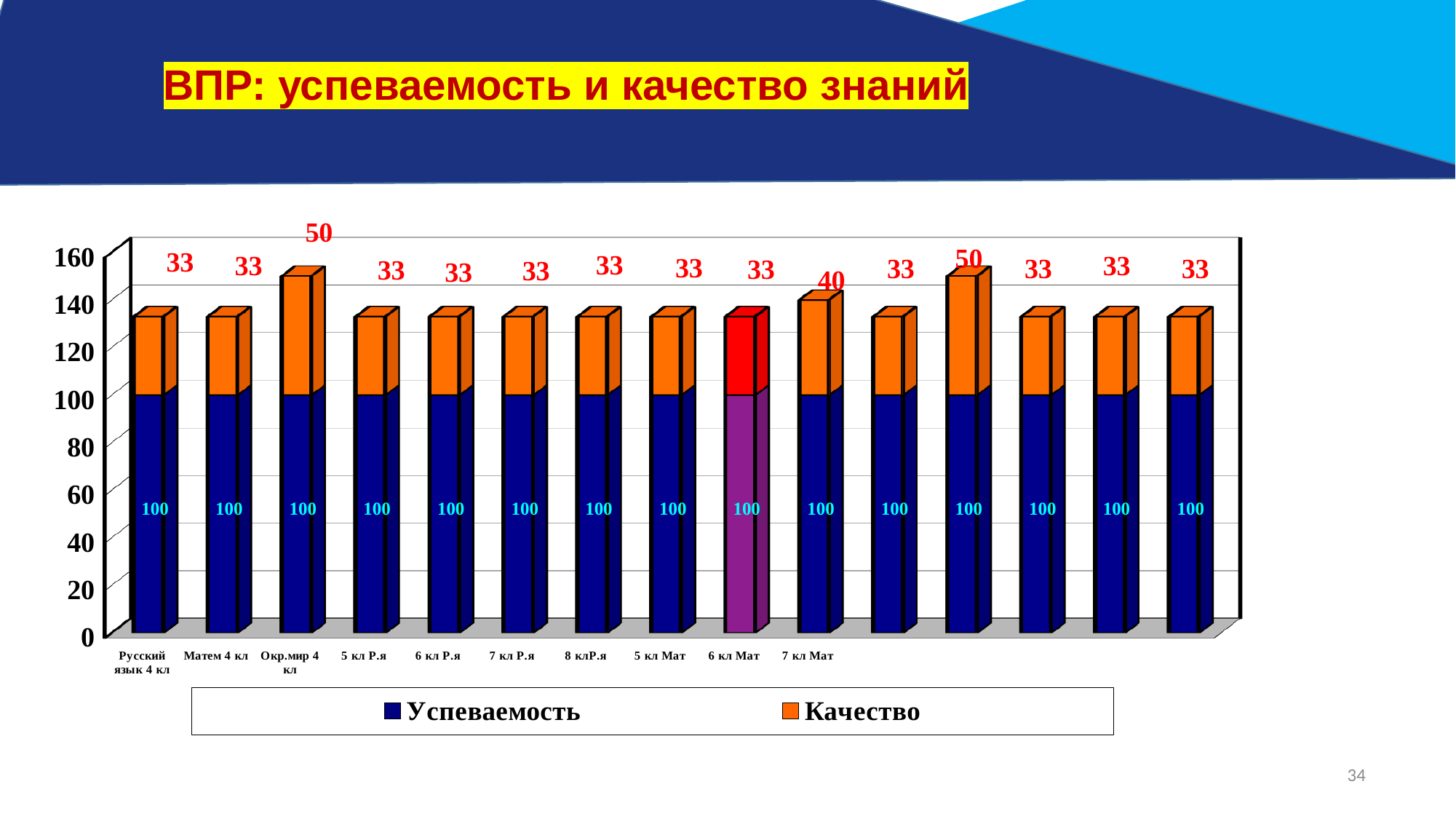
What are the two series named in the legend? Успеваемость and Качество Is the total of the stacked bar for 6 кл Мат greater or less than 120? greater What kind of chart is shown on the slide? bar chart What is the Качество value for Матем 4 кл? 33 What is the Успеваемость value for 5 кл Р.я? 100 What is the Качество value for 7 кл Мат? 40 What is the total of the stacked bar for 7 кл Мат? 140 What is the total height of the stacked bar for Окр.мир 4 кл (Успеваемость plus Качество)? 150 What is the Качество value for Окр.мир 4 кл? 50 How many series does the legend list? 2 Which has the higher Качество value: Окр.мир 4 кл or 6 кл Мат? Окр.мир 4 кл What is the difference between the Качество values for Окр.мир 4 кл and 7 кл Мат? 10